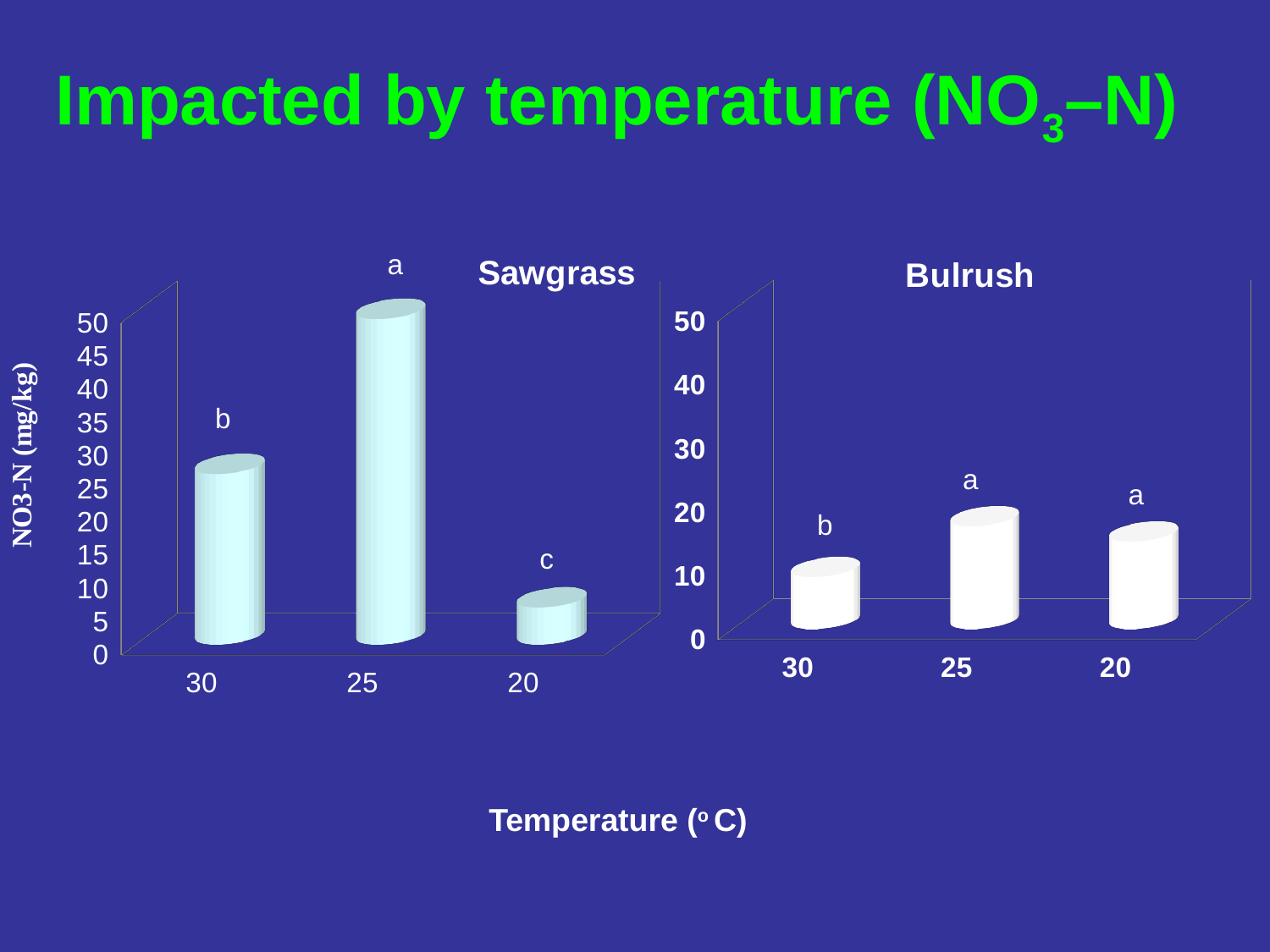
In the Bulrush chart, which temperature has the lowest NO3-N value? 30 In the Sawgrass chart, is the value for 25 greater or less than 40? greater What is the label on the vertical axis of the Sawgrass chart? NO3-N (mg/kg) In the Sawgrass chart, which is larger, the value for 30 or the value for 20? 30 How many bars are shown in the Bulrush chart? 3 In the Sawgrass chart, is the value for 30 greater or less than 20? greater In the Sawgrass chart, which temperature has the lowest NO3-N value? 20 In the Bulrush chart, is the value for 25 greater or less than 10? greater In the Sawgrass chart, which temperature has the highest NO3-N value? 25 What kind of chart is the Sawgrass chart? bar chart